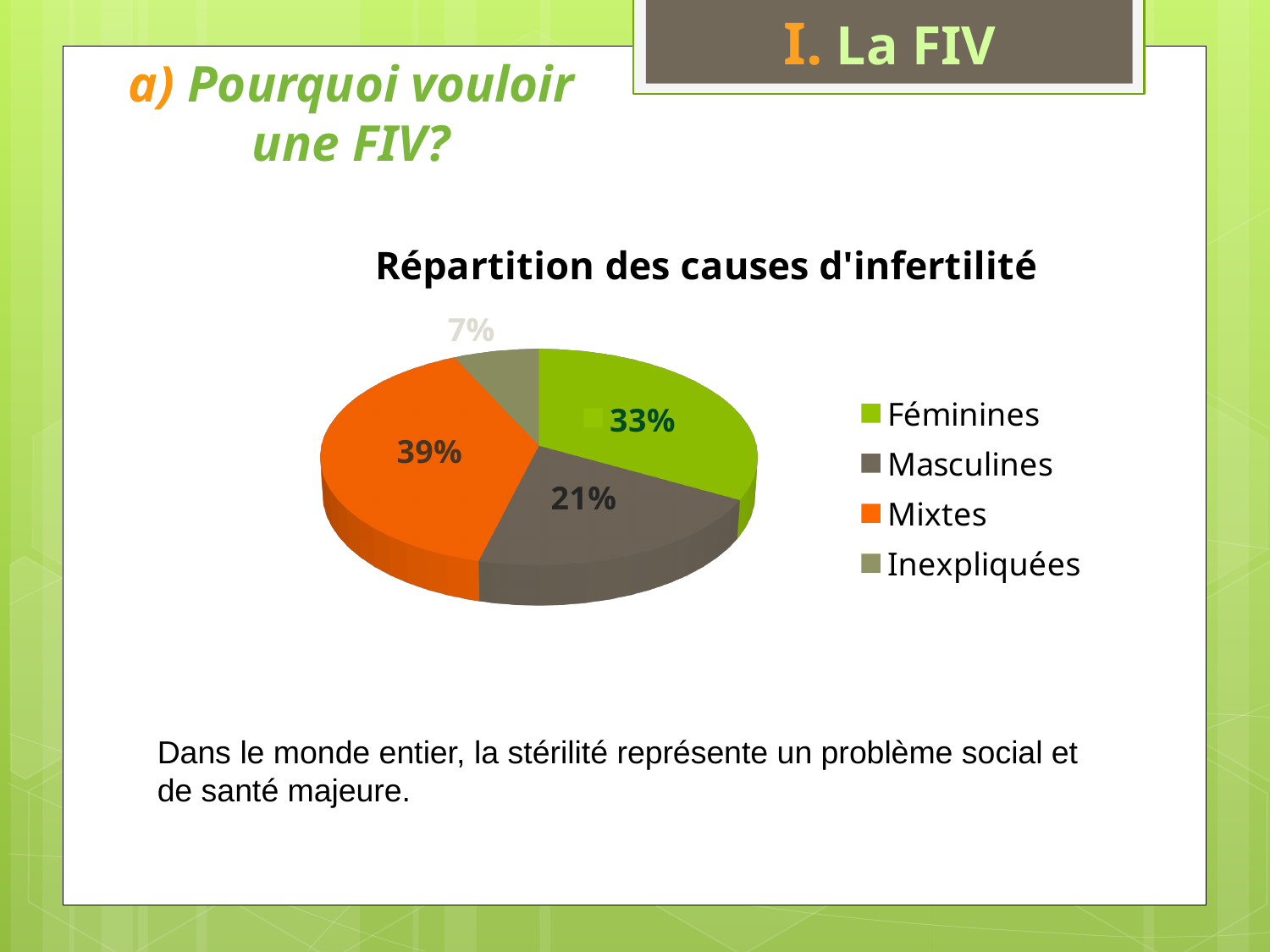
What kind of chart is shown on the slide? pie chart What is the title of the chart? Répartition des causes d'infertilité Which category has the largest share of the pie? Mixtes How many categories does the legend list? 4 What is the difference in percentage points between Mixtes and Masculines? 18 What percentage of the pie is Féminines? 33% Which category has the smallest share of the pie? Inexpliquées What percentage of the pie is Masculines? 21% What percentage of the pie is Inexpliquées? 7% What percentage of the pie is Mixtes? 39% Which is larger, the share for Féminines or the share for Masculines? Féminines What colour is the Mixtes slice? orange